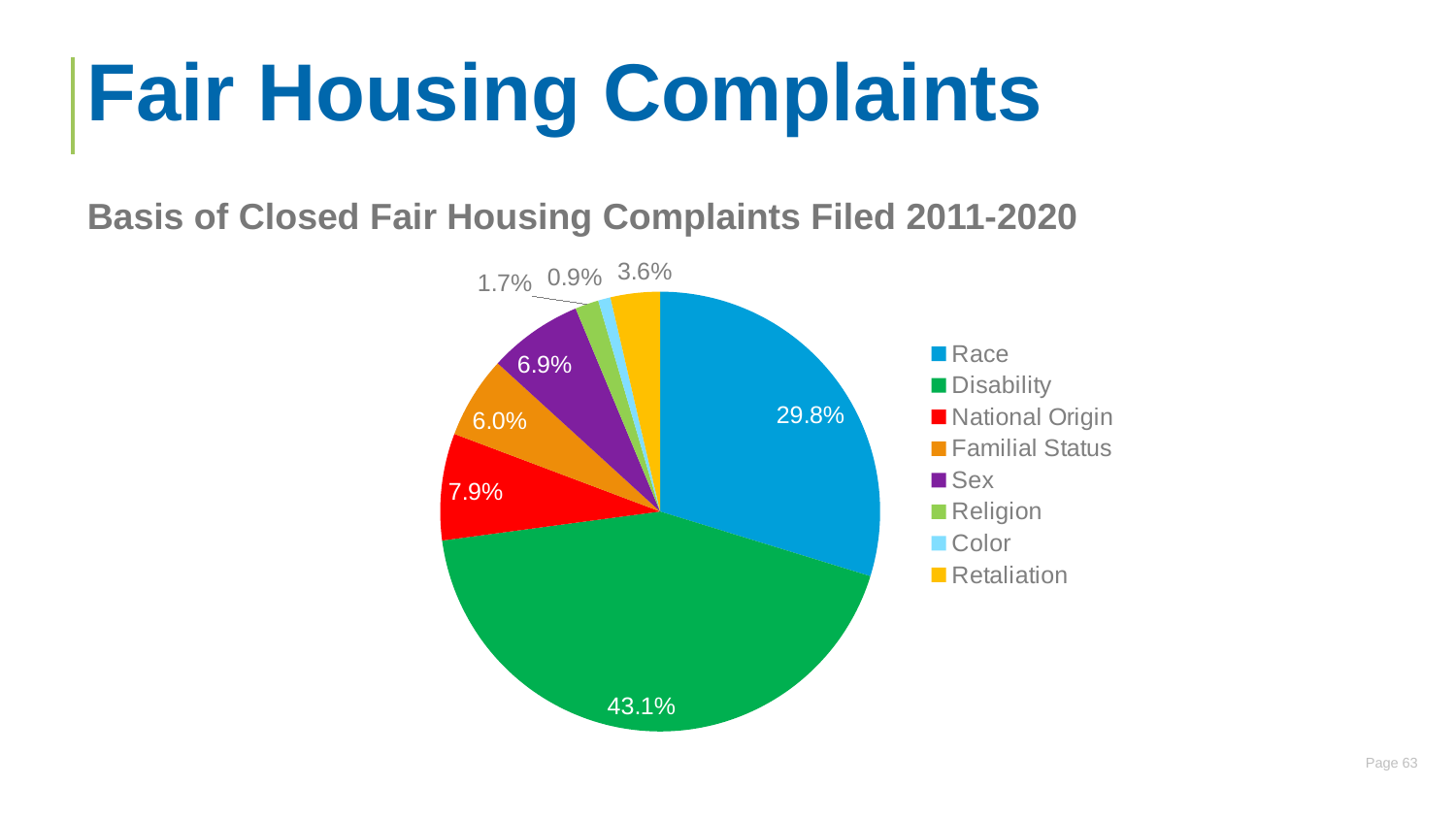
What percentage of complaints was based on National Origin? 7.9% What share of closed fair housing complaints was filed on the basis of Disability? 43.1% How many bases of complaint are shown in the pie chart? 8 What percentage of complaints was based on Familial Status? 6.0% Which has a larger share of complaints, Sex or Familial Status? Sex What is the difference in percentage points between the Disability and Race shares? 13.3 What kind of chart is shown on the slide? Pie chart Which basis accounts for the largest share of closed fair housing complaints? Disability What is the title of the pie chart? Basis of Closed Fair Housing Complaints Filed 2011-2020 Which basis accounts for the smallest share of closed fair housing complaints? Color What percentage of complaints was based on Retaliation? 3.6% What share of closed fair housing complaints was filed on the basis of Race? 29.8%